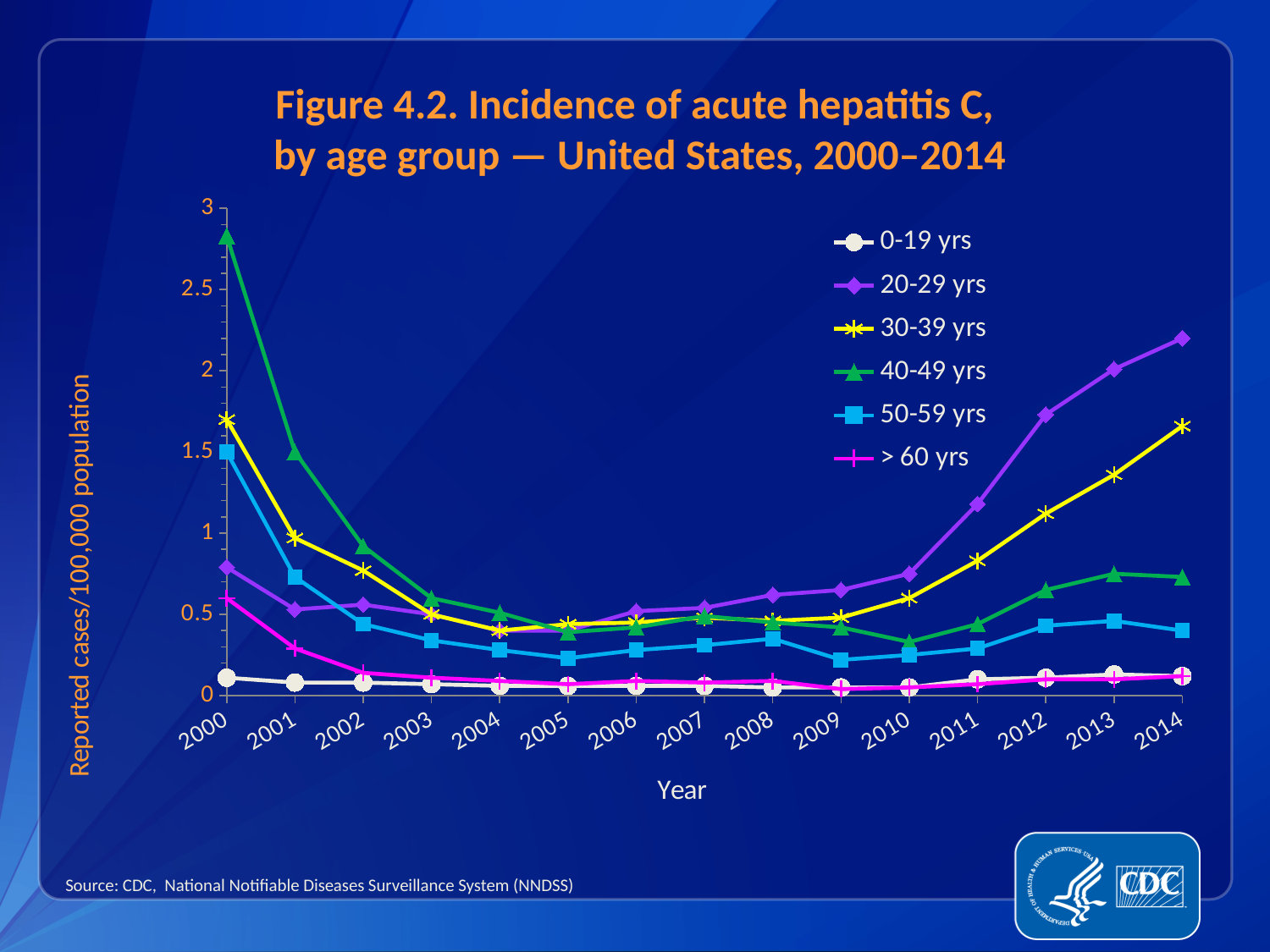
Which age group had the highest incidence in 2014? 20-29 yrs Is the value for 20-29 yrs in 2014 greater or less than 2? greater What is the label of the y axis? Reported cases/100,000 population How many years are plotted along the x axis? 15 What kind of chart is shown on the slide? line chart Which age group had the lowest incidence in 2000? 0-19 yrs Is the value for 40-49 yrs in 2000 greater or less than 2.5? greater Which age group had the highest incidence in 2000? 40-49 yrs In 2014, which is larger: the value for 30-39 yrs or the value for 40-49 yrs? 30-39 yrs Is the value for 40-49 yrs in 2014 greater or less than 0.5? greater How many series does the legend list? 6 Does the incidence for 20-29 yrs rise or fall from 2010 to 2014? rise